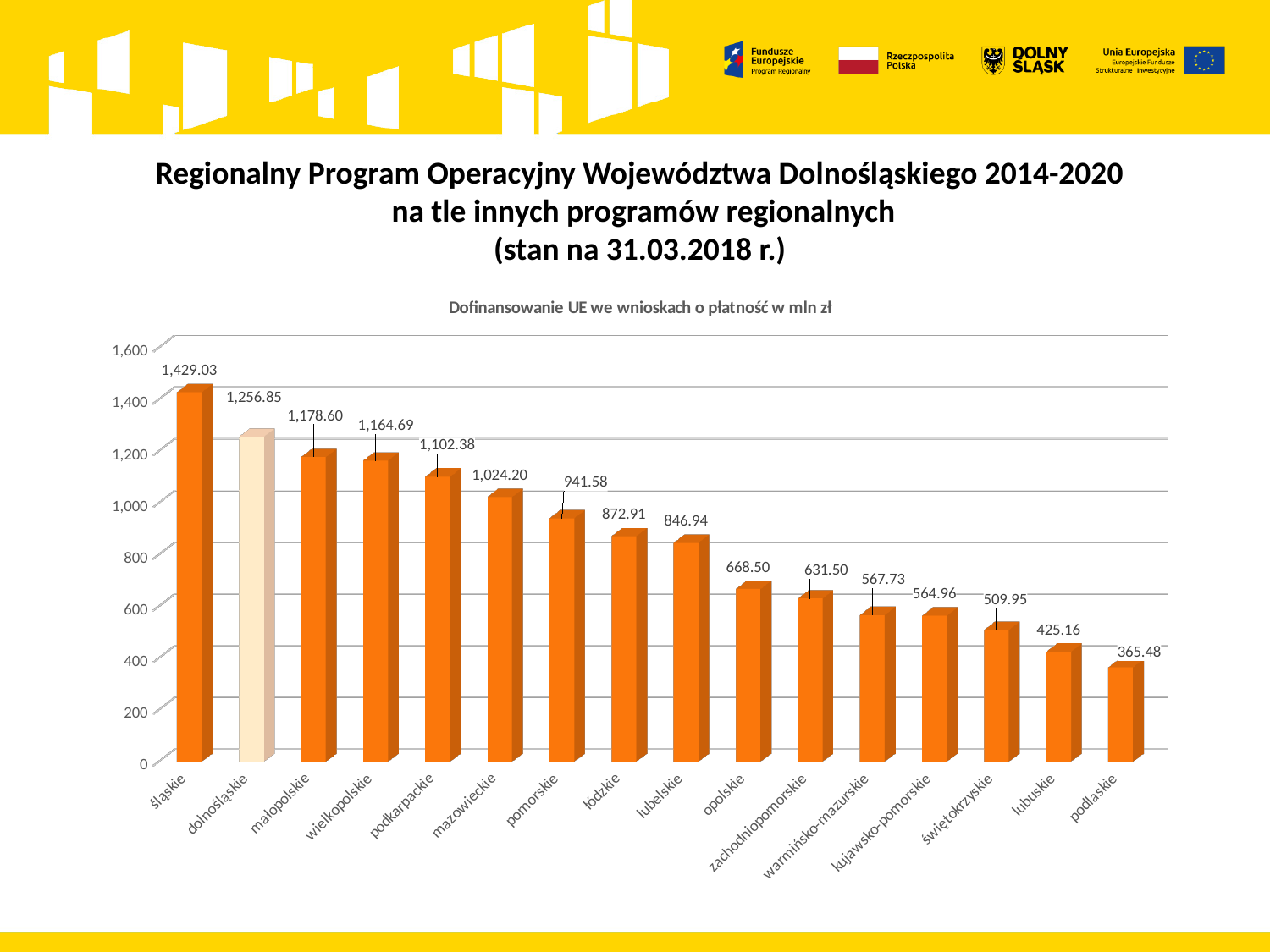
What is the value for lubuskie? 425.16 Which category has the lowest value? podlaskie What kind of chart is this? bar chart Is the value for mazowieckie greater or less than 1,000? greater Which category has the highest value? śląskie How many categories are shown on the x axis? 16 What is the value for dolnośląskie? 1,256.85 Do the values rise or fall from left to right along the x axis? fall Which is larger, the value for opolskie or the value for zachodniopomorskie? opolskie What is the difference between the values for śląskie and dolnośląskie? 172.18 What is the title of the chart? Dofinansowanie UE we wnioskach o płatność w mln zł What is the value for pomorskie? 941.58